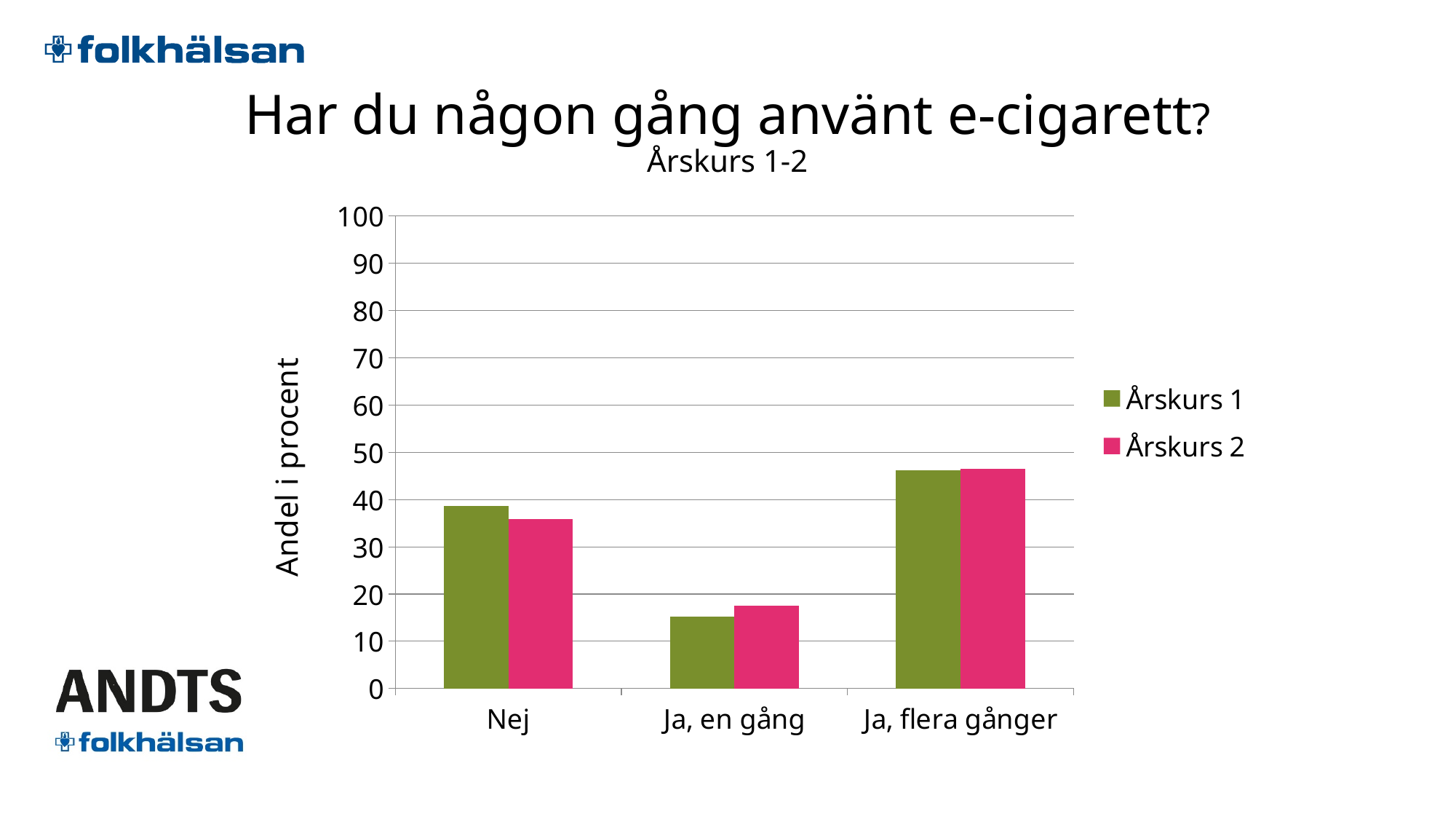
Which category has the highest value for Årskurs 1? Ja, flera gånger What is the label of the y axis? Andel i procent Is the value for Årskurs 1 in the Nej category greater or less than 30? greater How many series does the legend list? 2 How many categories are shown on the x axis? 3 What kind of chart is shown on the slide? bar chart In the Nej category, which series has the larger value, Årskurs 1 or Årskurs 2? Årskurs 1 Is the value for Årskurs 2 in the Ja, en gång category greater or less than 20? less Is the value for Årskurs 1 in the Ja, flera gånger category greater or less than 50? less In the Ja, en gång category, which series has the larger value, Årskurs 1 or Årskurs 2? Årskurs 2 Which category has the lowest value for Årskurs 2? Ja, en gång